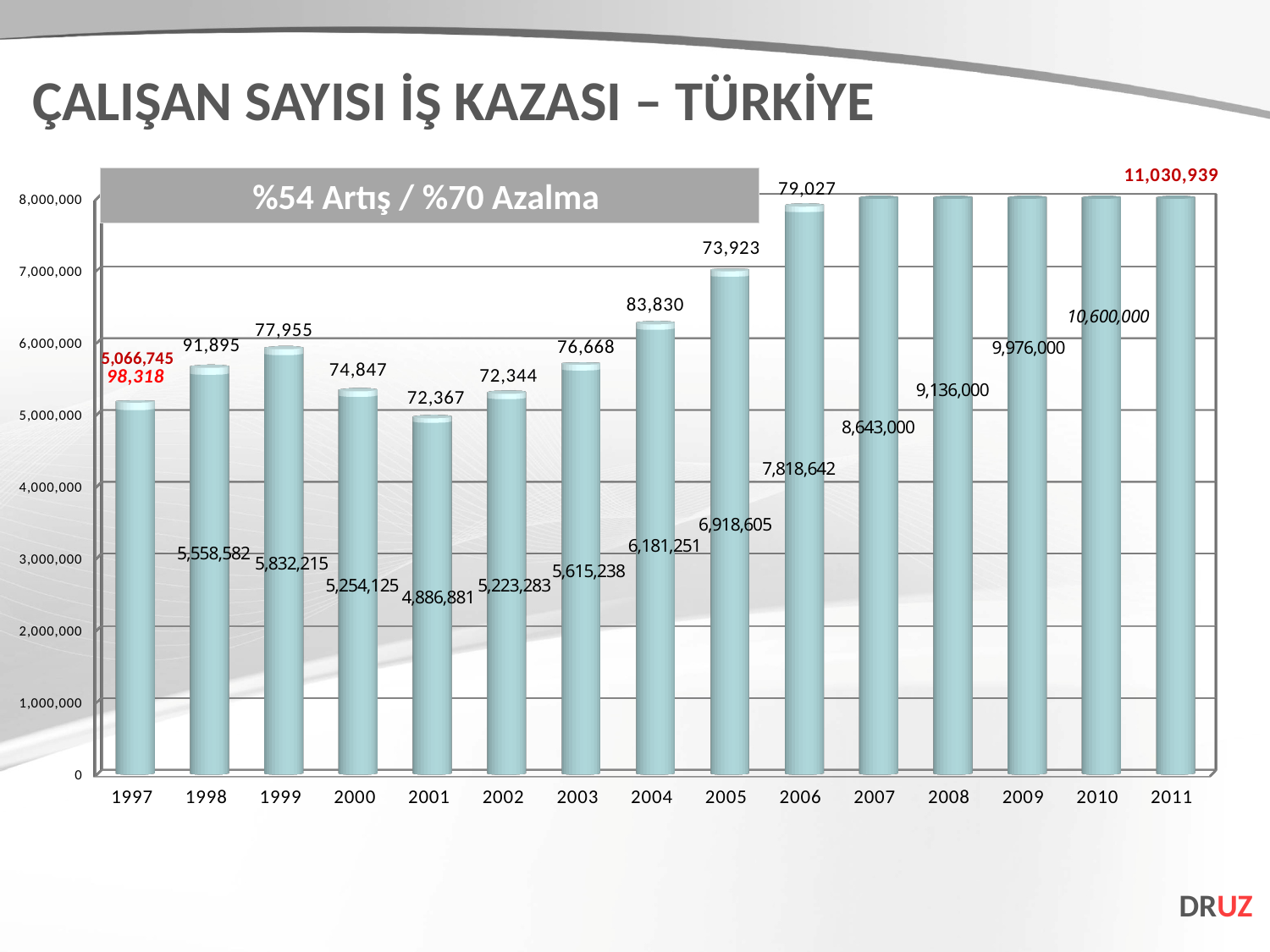
What is the worker count label shown for 2001? 4,886,881 Which year has the larger worker count label, 1998 or 2000? 1998 What text is shown in the grey box at the top of the chart? %54 Artış / %70 Azalma What is the accident count label shown above the 2004 bar? 83,830 Which year has the lowest worker count label? 2001 Which year has the highest worker count label? 2011 What type of chart is shown on the slide? bar chart What is the difference between the worker count labels for 2010 and 2009? 624,000 What is the accident count label shown above the 1997 bar? 98,318 What is the worker count label shown for 2011? 11,030,939 What is the worker count label shown for 2006? 7,818,642 How many years are shown on the x axis of the chart? 15